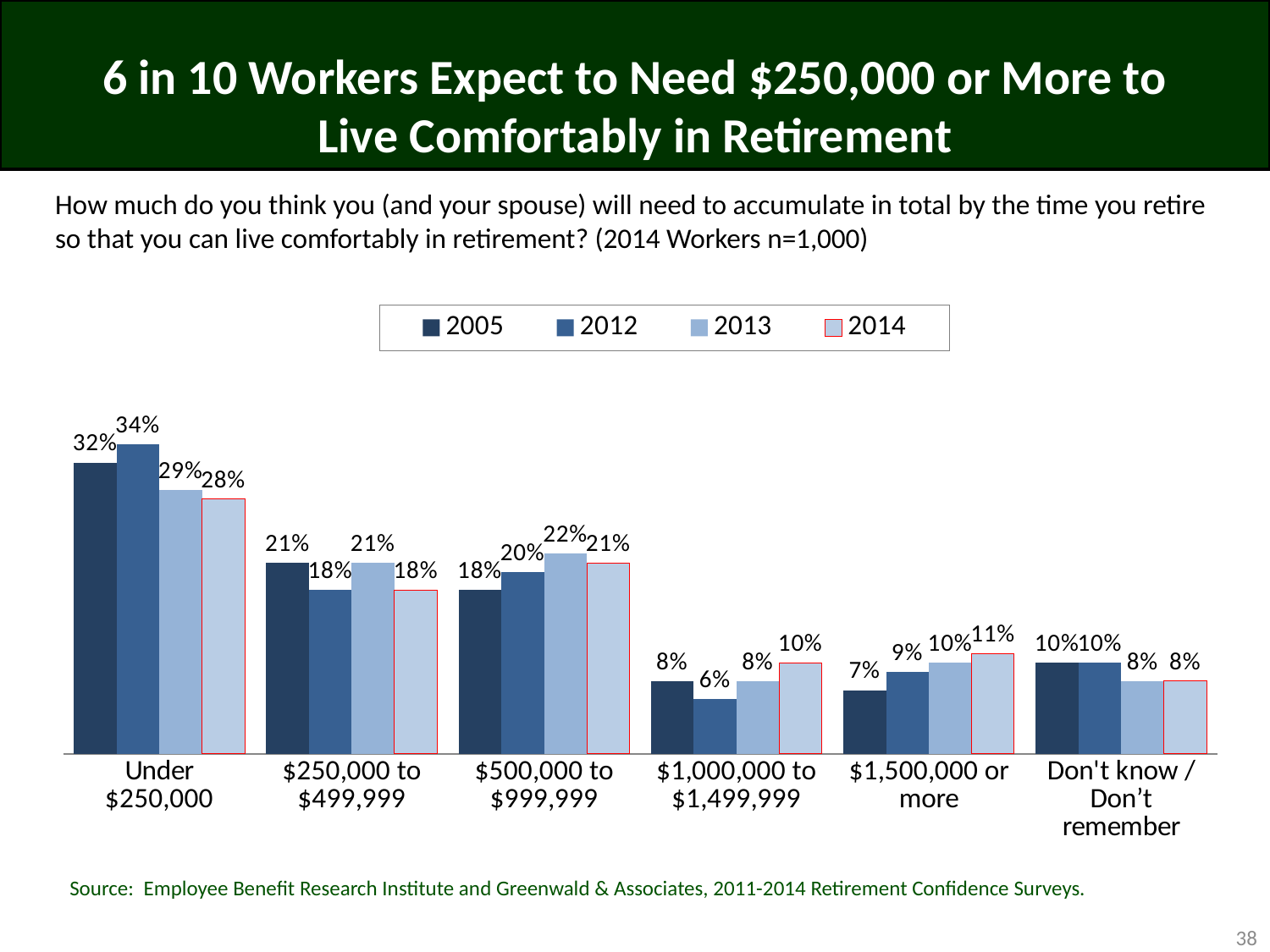
Which category has the lowest 2005 value? $1,500,000 or more How many series does the legend list? 4 What kind of chart is shown on the slide? Bar chart Which is larger for the "$1,500,000 or more" category: the 2005 value or the 2014 value? 2014 Do the values for the "$1,500,000 or more" category rise or fall from 2005 to 2014? Rise What is the 2013 value for the "$500,000 to $999,999" category? 22% What is the 2012 value for the "$1,000,000 to $1,499,999" category? 6% What is the 2014 value for the "Under $250,000" category? 28% What is the difference between the 2005 and 2014 values for the "Under $250,000" category? 4% How many categories are shown on the x axis? 6 Which category has the highest 2012 value? Under $250,000 Which series is drawn with a red outline in the legend? 2014